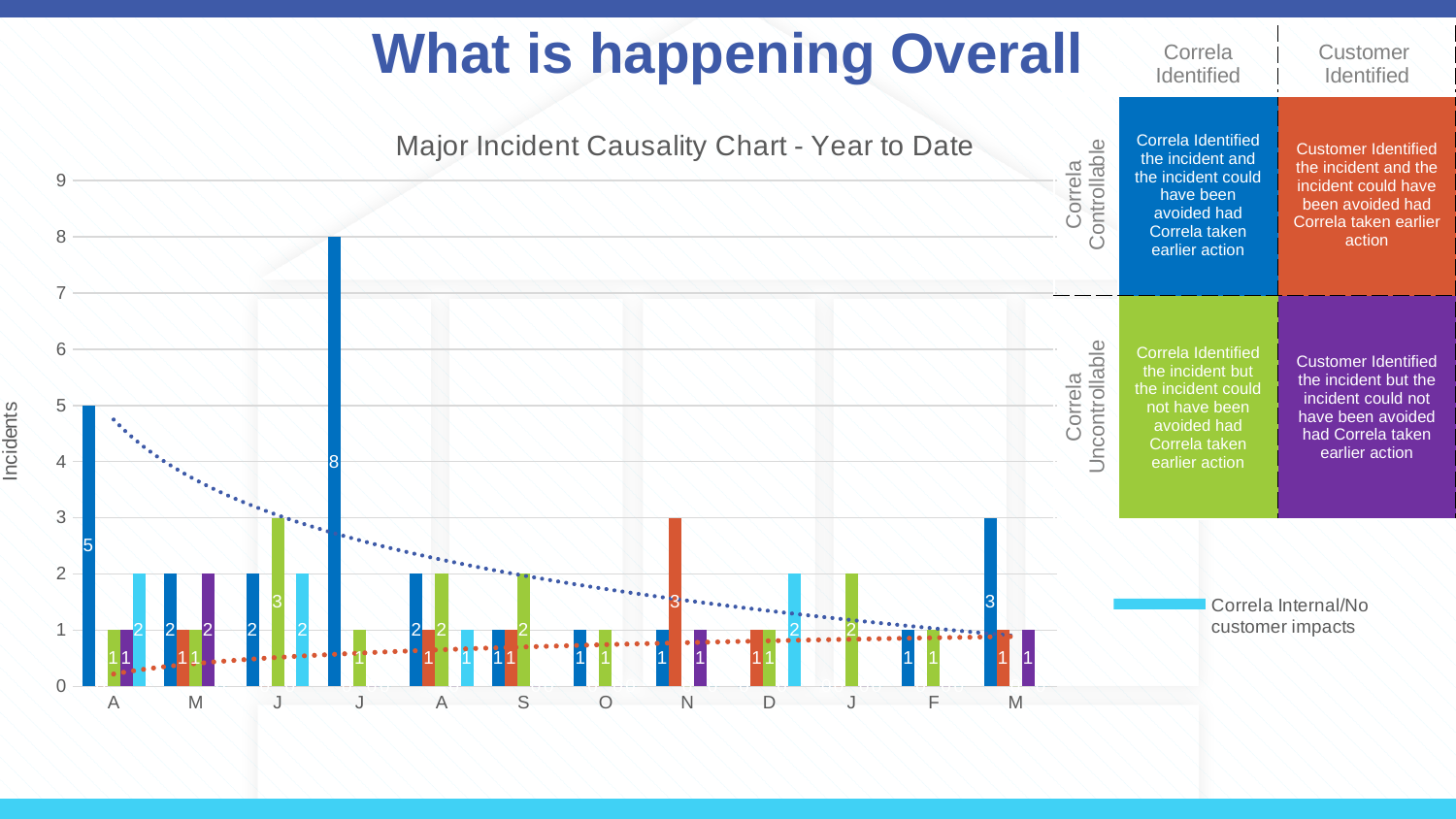
What is the label on the vertical axis of the chart? Incidents What is the value of the green bar in the third month (J) of the chart? 3 What type of chart is shown on the slide? bar chart What is the title of the chart on the slide? Major Incident Causality Chart - Year to Date How many month categories are shown along the x axis of the chart? 12 What is the difference between the tallest bar (8) and the dark blue bar in the first month (5)? 3 What is the value of the orange bar in the month labelled N? 3 What is the value of the dark blue bar in the first month (A) of the chart? 5 Is the tallest bar in the chart greater or less than 7? greater What is the value of the dark blue bar in the last month (M) of the chart? 3 What is the highest value labelled on any bar in the chart? 8 Which is larger: the dark blue bar in the first month (A) or the dark blue bar in the last month (M)? the first month (A)